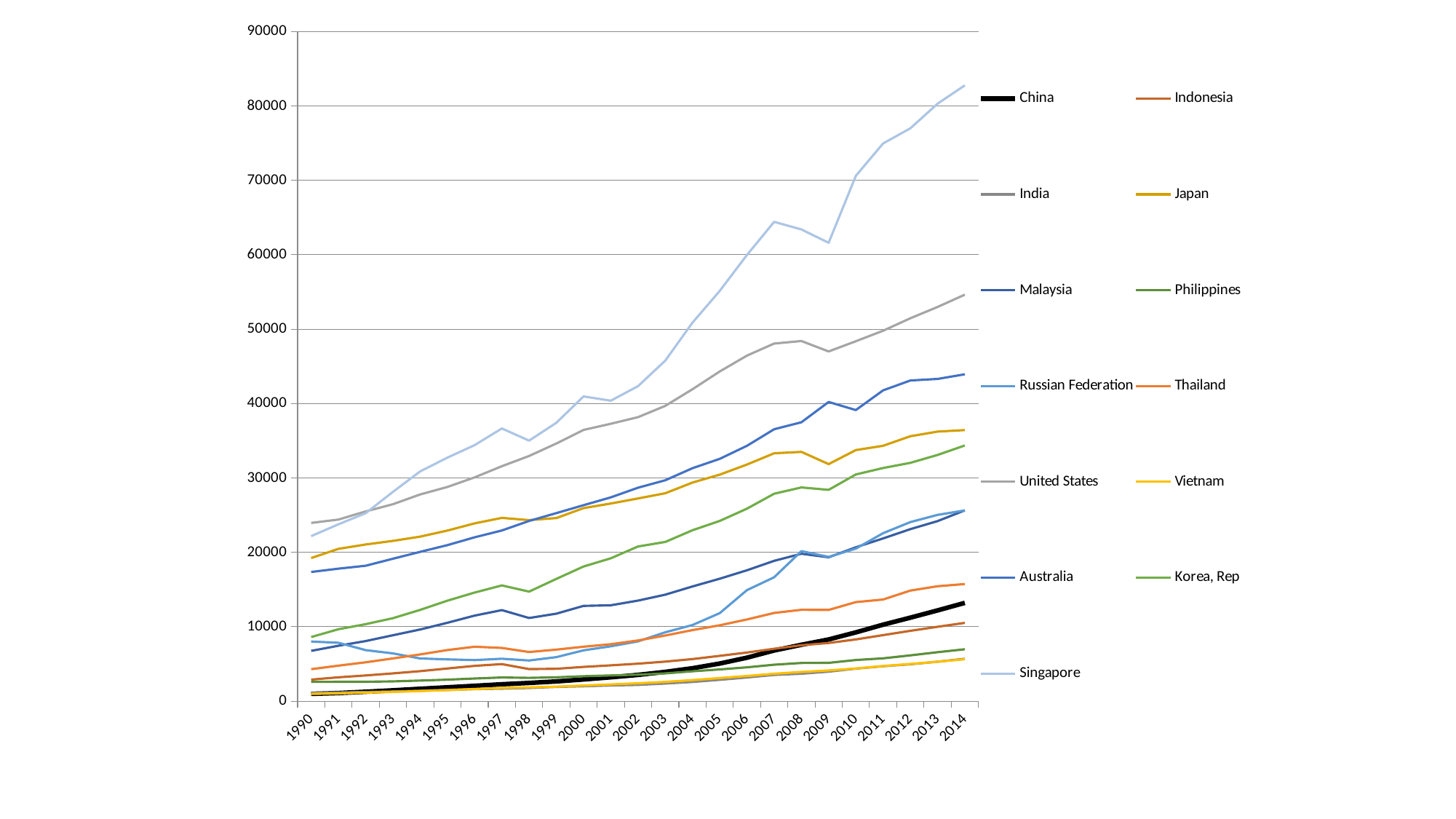
Is the value for Singapore in 2014 greater or less than 80000? greater Is the value for Australia in 2014 greater or less than 40000? greater What kind of chart is shown on the slide? line chart Is the value for Korea, Rep in 2014 greater or less than 30000? greater What colour is the China line in the legend? black How many series does the legend list? 13 Which series has the highest value in 2014? Singapore Does the Singapore line rise or fall overall from 1990 to 2014? rises How many years are shown along the x axis? 25 Which is larger in 2014, the value for Singapore or the value for Japan? Singapore